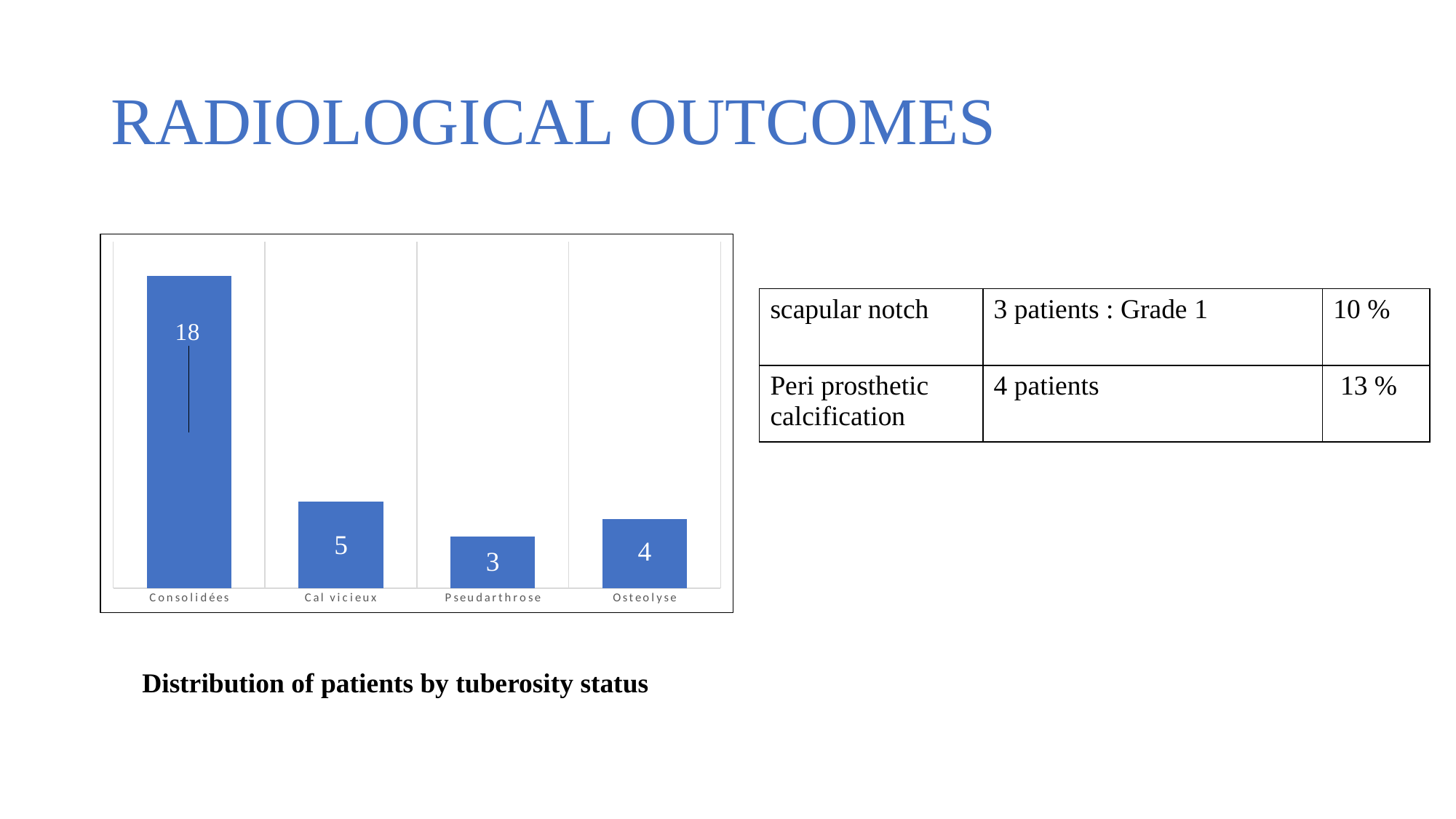
Which category has the highest value in the bar chart? Consolidées What is the value for Pseudarthrose in the bar chart? 3 How many categories are shown in the bar chart? 4 What is the difference between the values for Osteolyse and Pseudarthrose? 1 Which category has the lowest value in the bar chart? Pseudarthrose What kind of chart is shown on the slide? Bar chart What is the value for Consolidées in the bar chart? 18 Which is larger, the value for Cal vicieux or the value for Osteolyse? Cal vicieux What is the value for Osteolyse in the bar chart? 4 What is the value for Cal vicieux in the bar chart? 5 What is the difference between the values for Consolidées and Cal vicieux? 13 What is the caption below the bar chart? Distribution of patients by tuberosity status